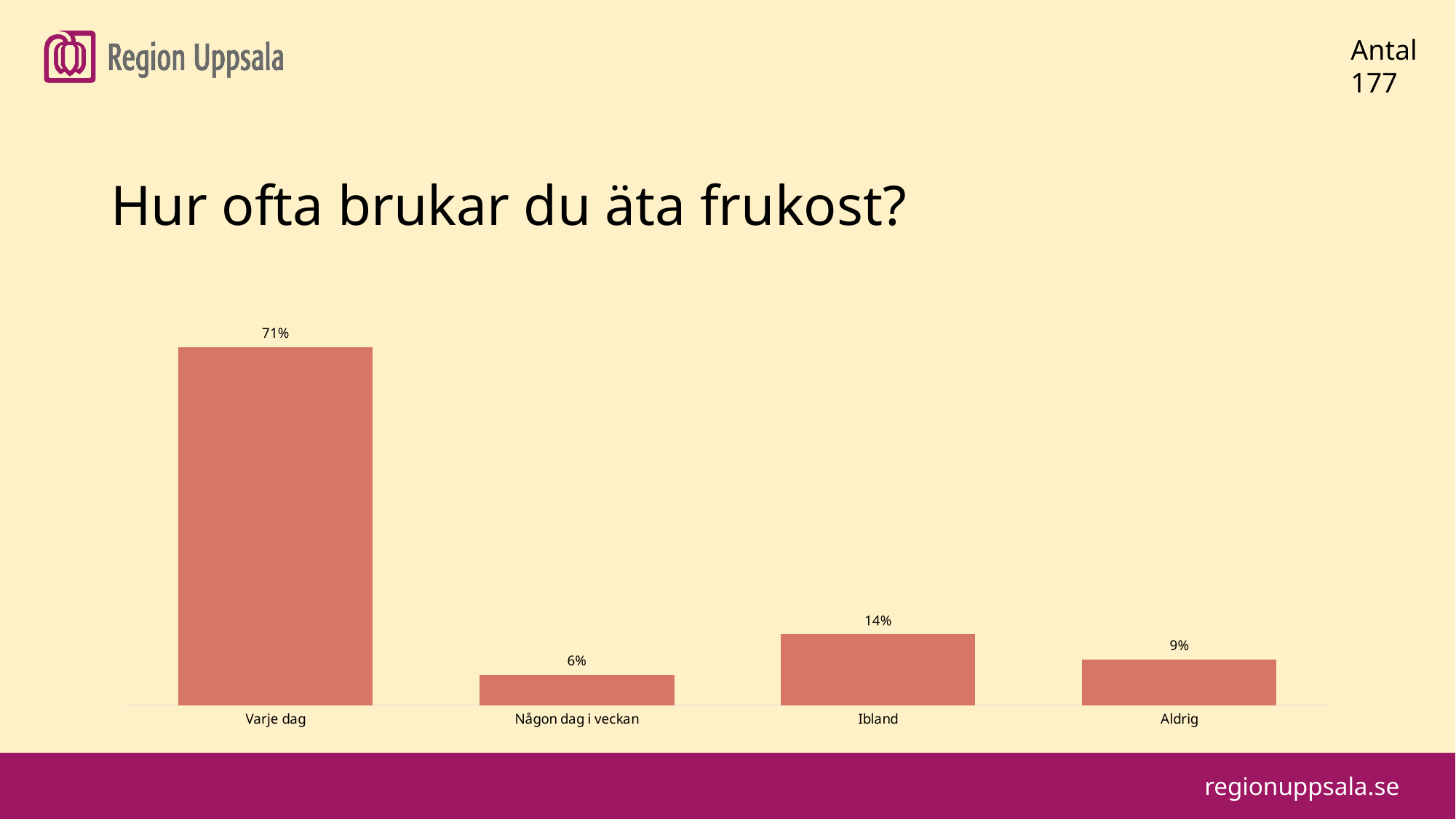
What is the value for "Aldrig"? 9% What kind of chart is shown on the slide? Bar chart What is the difference between the values for "Ibland" and "Aldrig"? 5% Which category has the lowest value? Någon dag i veckan What is the value for "Någon dag i veckan"? 6% What is the title of the chart on the slide? Hur ofta brukar du äta frukost? Which category has the highest value? Varje dag How many categories are shown in the chart? 4 What is the value for "Ibland"? 14% Which is larger, the value for "Ibland" or the value for "Aldrig"? Ibland What is the value for "Varje dag"? 71% What is the difference between the values for "Varje dag" and "Ibland"? 57%